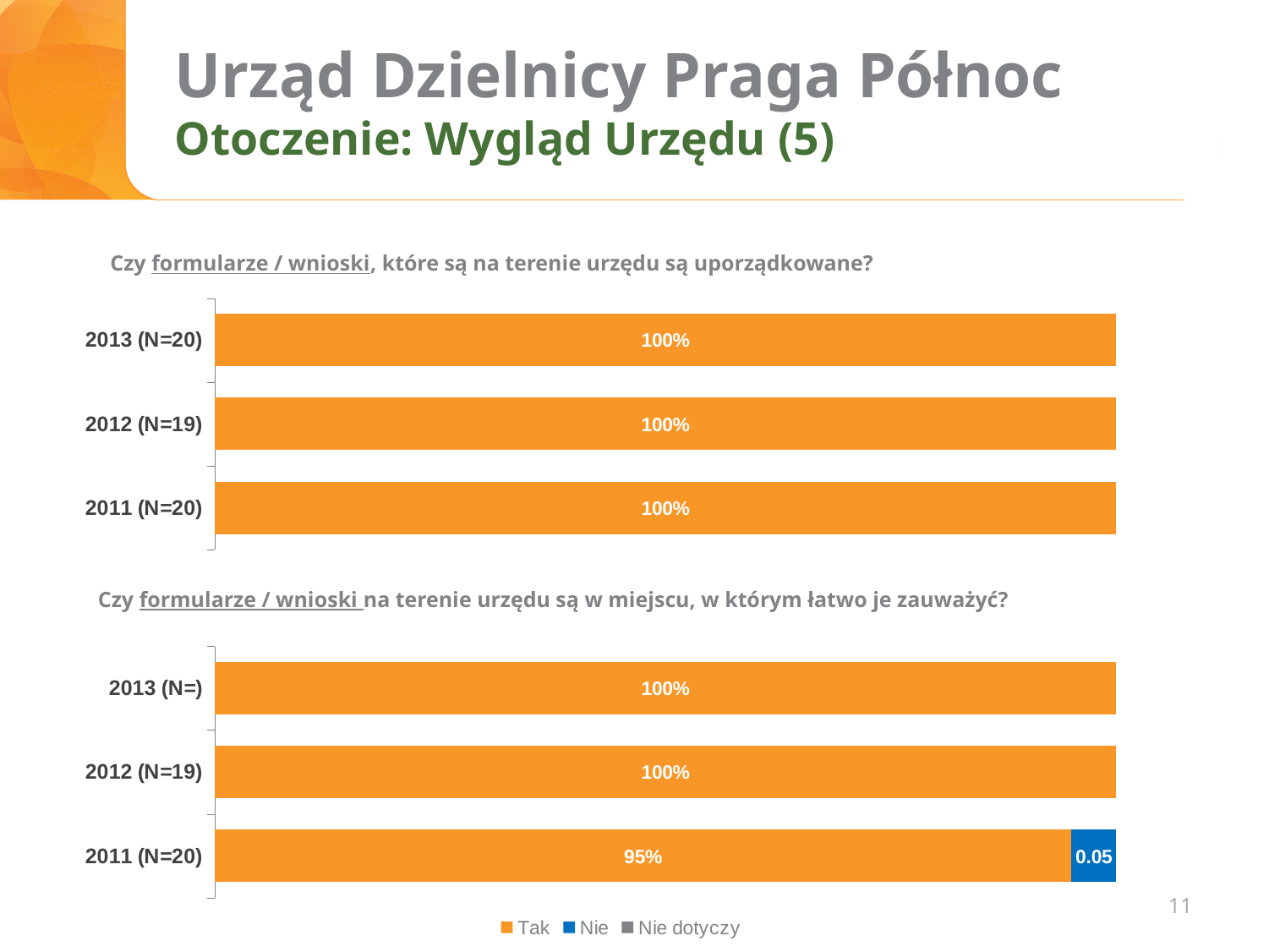
In the bottom chart ("Czy formularze / wnioski na terenie urzędu są w miejscu, w którym łatwo je zauważyć?"), which year has the lowest "Tak" value? 2011 (N=20) In the bottom chart ("Czy formularze / wnioski na terenie urzędu są w miejscu, w którym łatwo je zauważyć?"), what is the value for "Tak" in 2012 (N=19)? 100% In the bottom chart ("Czy formularze / wnioski na terenie urzędu są w miejscu, w którym łatwo je zauważyć?"), what is the difference between the "Tak" value for 2012 (N=19) and for 2011 (N=20)? 5% In the bottom chart ("Czy formularze / wnioski na terenie urzędu są w miejscu, w którym łatwo je zauważyć?"), what is the value for "Tak" in 2011 (N=20)? 95% What type of chart is the bottom chart ("Czy formularze / wnioski na terenie urzędu są w miejscu, w którym łatwo je zauważyć?")? bar chart In the top chart ("Czy formularze / wnioski, które są na terenie urzędu są uporządkowane?"), what is the value for "Tak" in 2013 (N=20)? 100% In the top chart ("Czy formularze / wnioski, które są na terenie urzędu są uporządkowane?"), what is the value for "Tak" in 2011 (N=20)? 100% How many series does the legend at the bottom of the slide list? 3 How many year categories does the top chart ("Czy formularze / wnioski, które są na terenie urzędu są uporządkowane?") show? 3 In the bottom chart ("Czy formularze / wnioski na terenie urzędu są w miejscu, w którym łatwo je zauważyć?"), is the "Tak" value for 2013 larger or smaller than for 2011 (N=20)? larger What are the legend entries listed at the bottom of the slide? Tak, Nie, Nie dotyczy In the bottom chart ("Czy formularze / wnioski na terenie urzędu są w miejscu, w którym łatwo je zauważyć?"), what is the value for "Nie" in 2011 (N=20)? 0.05